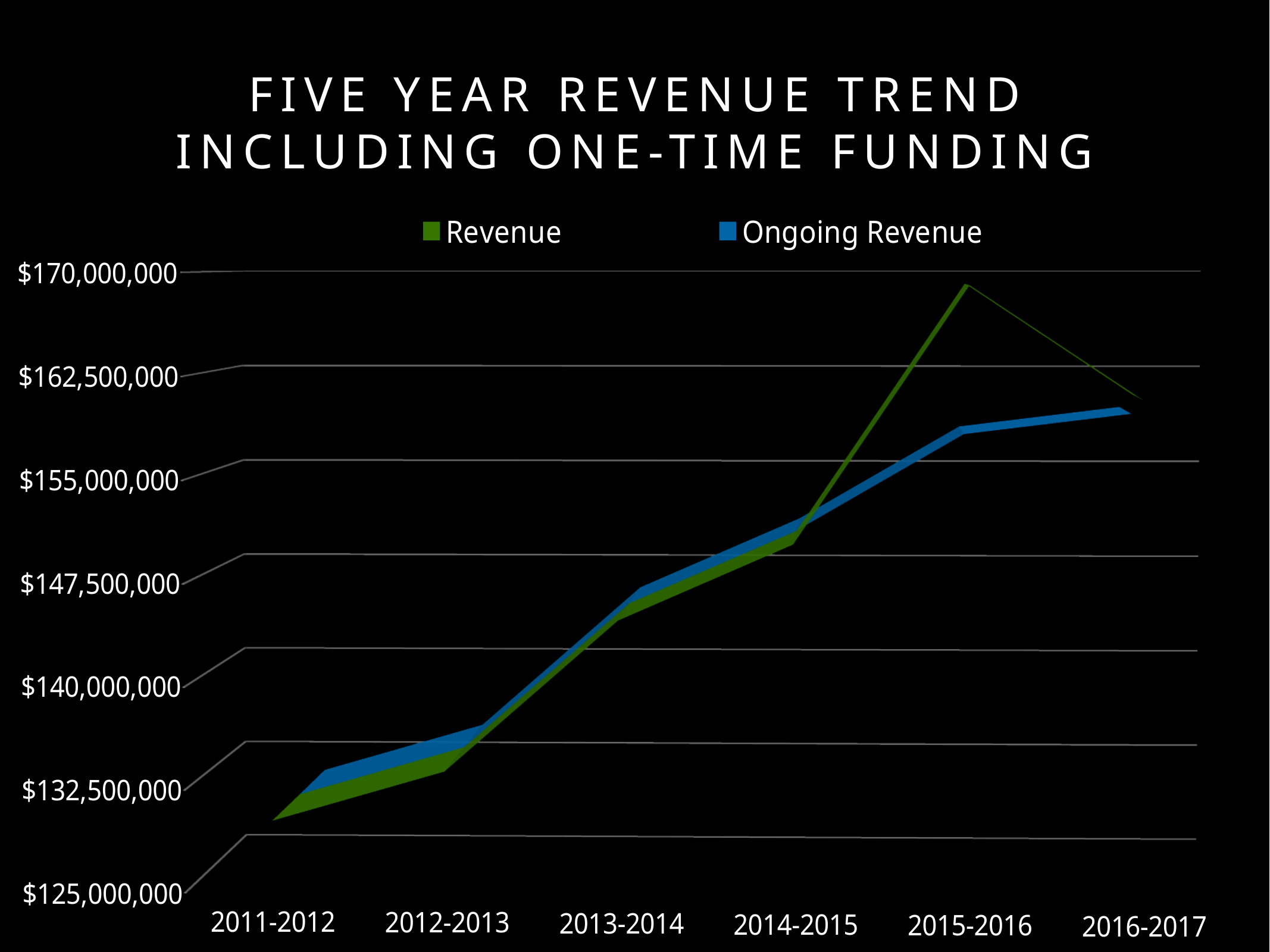
Does Ongoing Revenue rise or fall from 2011-2012 to 2016-2017? rise What colour represents the Ongoing Revenue series? blue How many series does the legend list? 2 Is the Revenue value for 2011-2012 greater or less than $132,500,000? less In which year is Revenue lowest? 2011-2012 Is the Ongoing Revenue value for 2015-2016 greater or less than $155,000,000? greater What kind of chart is shown on the slide? line chart How many fiscal years are shown on the x axis? 6 In which year is Revenue highest? 2015-2016 Is the Revenue value for 2015-2016 greater or less than $162,500,000? greater In 2015-2016, which is larger: Revenue or Ongoing Revenue? Revenue